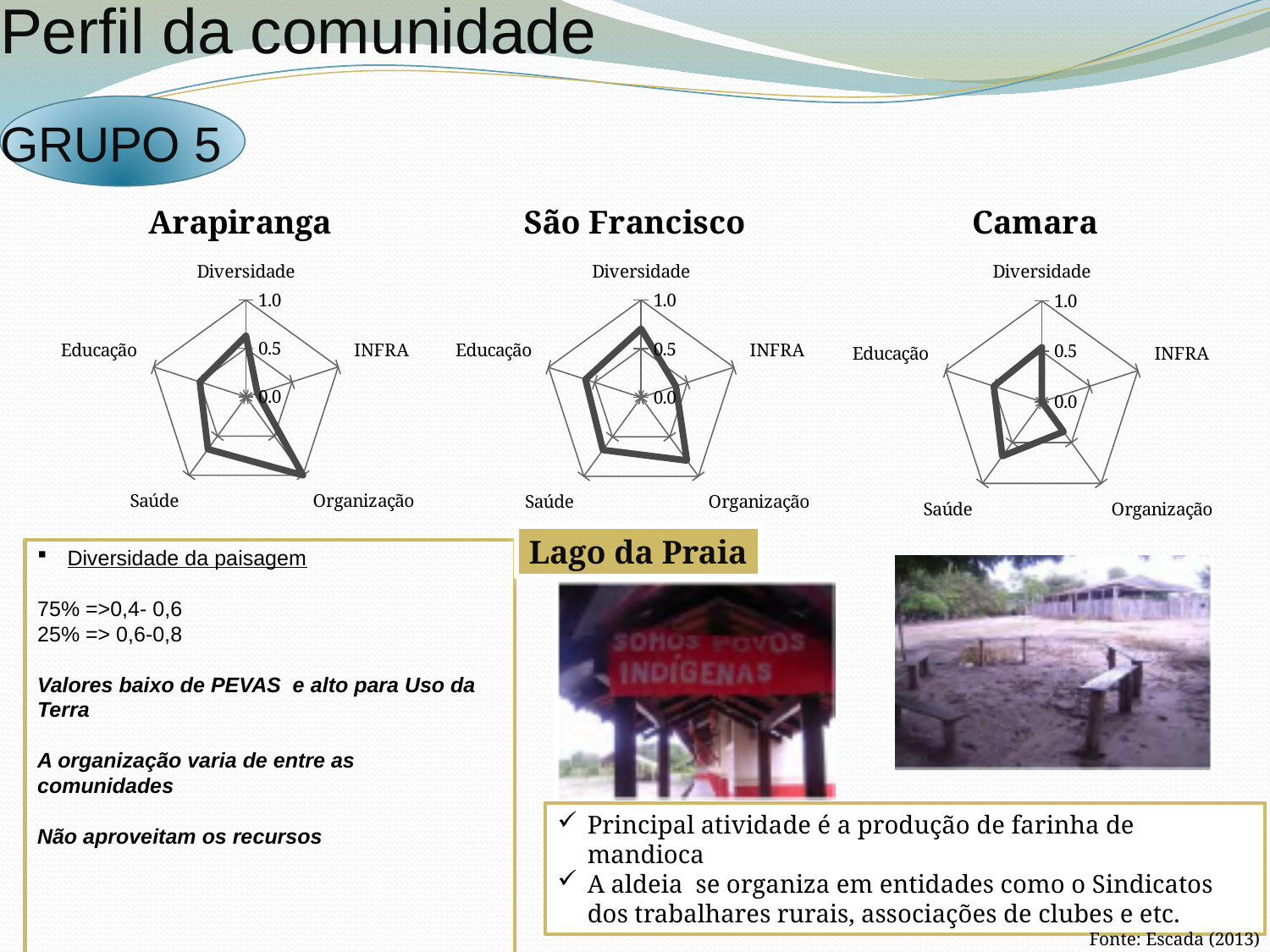
In the São Francisco chart, is the value for Diversidade greater or less than 0.5? greater In the Camara chart, which category has the lowest value? INFRA In the Arapiranga chart, which is larger, the value for Organização or the value for INFRA? Organização What kind of chart is used for the Arapiranga community profile? radar chart How many radar charts are shown on the slide? 3 In the Arapiranga chart, which category has the lowest value? INFRA What is the maximum value shown on the axis scale of the Camara radar chart? 1.0 In the Arapiranga chart, is the value for INFRA greater or less than 0.5? less How many axes (categories) does the São Francisco radar chart have? 5 In the Arapiranga chart, is the value for Organização greater or less than 0.5? greater In the Arapiranga chart, which category has the highest value? Organização